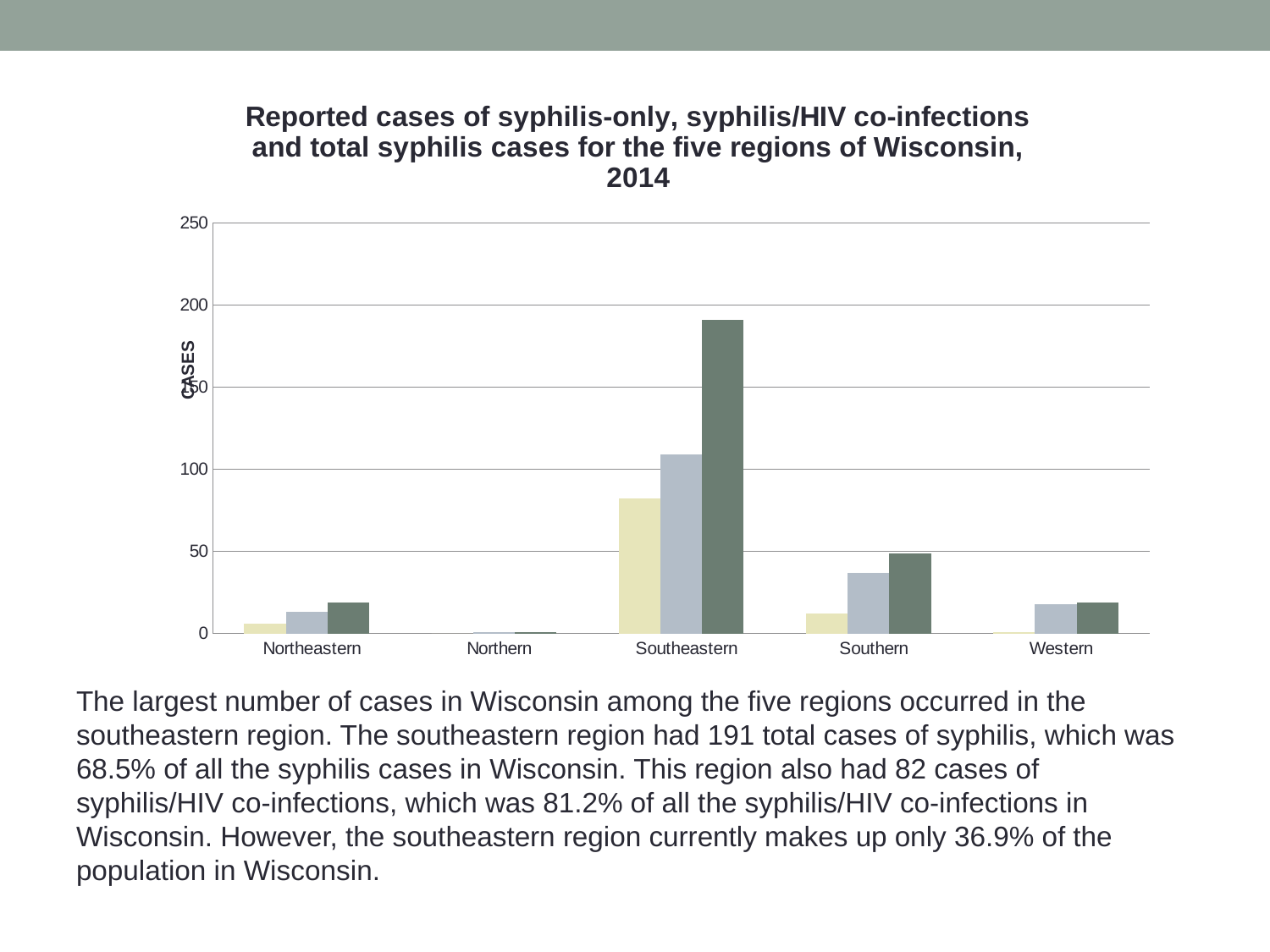
Which region has the taller tallest bar, Northeastern or Northern? Northeastern How many regions are shown on the x axis of the chart? 5 Which region has the lowest bars in the chart? Northern Which region has the highest bars in the chart? Southeastern What kind of chart is shown on the slide? bar chart Is the tallest bar for Southeastern greater or less than 150? greater How many bars are plotted for each region in the chart? 3 Which region has the taller tallest bar, Southern or Western? Southern Is the tallest bar for Western greater or less than 50? less Is the tallest bar for Southern greater or less than 100? less What is the label on the y axis of the chart? CASES